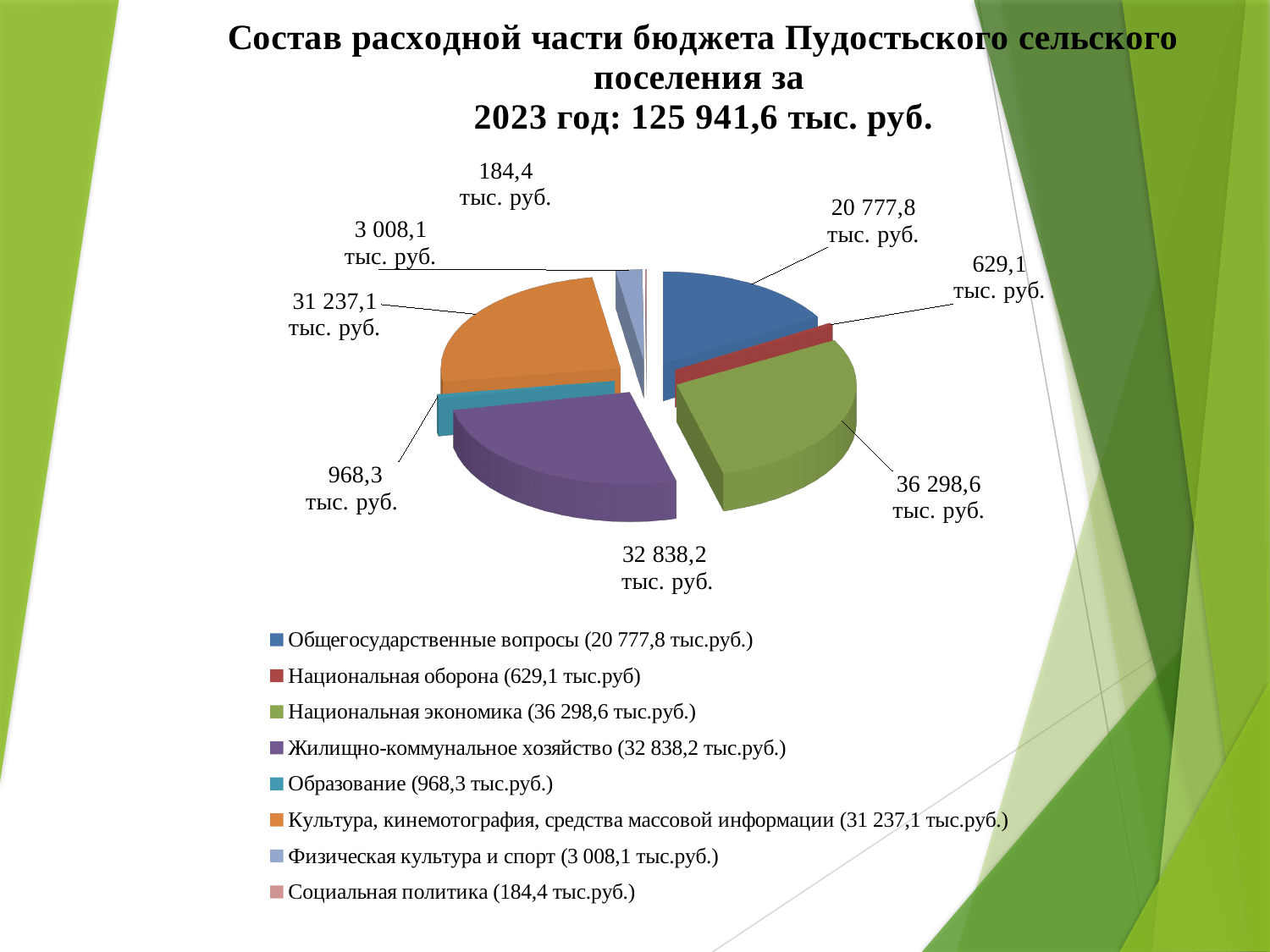
Which category has the smallest share of the budget expenditure? Социальная политика What kind of chart is shown on the slide? Pie chart What is the value for Жилищно-коммунальное хозяйство? 32 838,2 тыс. руб. How many categories does the pie chart show? 8 What is the difference between Национальная экономика and Жилищно-коммунальное хозяйство? 3 460,4 тыс. руб. What is the value for Социальная политика? 184,4 тыс. руб. Which is larger: Общегосударственные вопросы or Культура, кинемотография, средства массовой информации? Культура, кинемотография, средства массовой информации What colour is the slice for Образование? Teal What is the value for Физическая культура и спорт? 3 008,1 тыс. руб. Which category has the largest share of the budget expenditure? Национальная экономика What total budget expenditure for 2023 is stated in the chart title? 125 941,6 тыс. руб. What is the value for Национальная экономика? 36 298,6 тыс. руб.